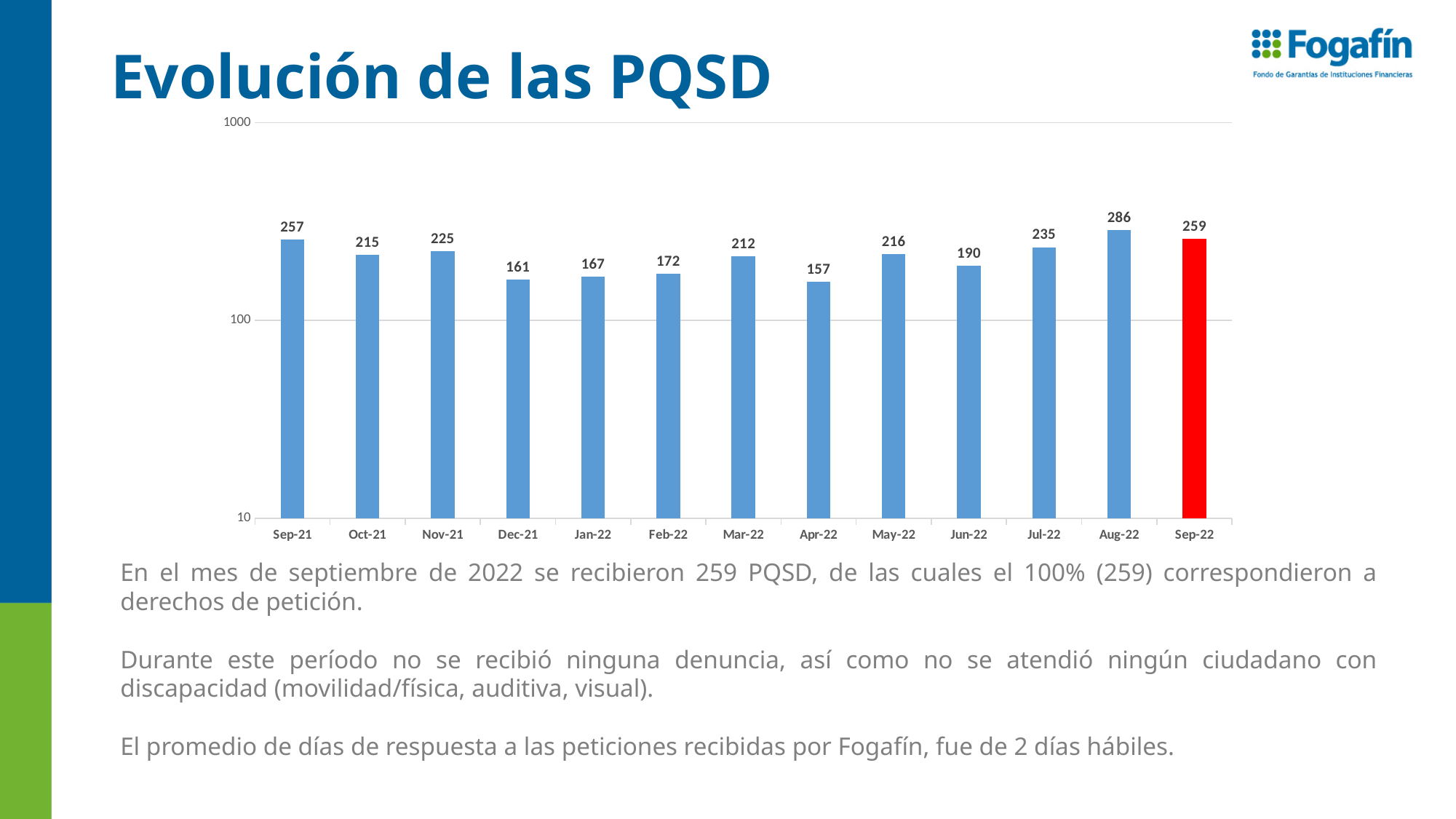
What is the difference between the values for Sep-21 and Apr-22? 100 What is the value for Mar-22? 212 Which month has the lowest value? Apr-22 What is the value for Sep-22? 259 What is the value for Dec-21? 161 Which is larger, the value for Jul-22 or the value for Jun-22? Jul-22 Is the value for Feb-22 greater or less than 100? greater Which bar is coloured red instead of blue? Sep-22 How many months are shown on the x axis? 13 What kind of chart is shown on the slide? bar chart What is the difference between the values for Aug-22 and Sep-22? 27 Which month has the highest value? Aug-22